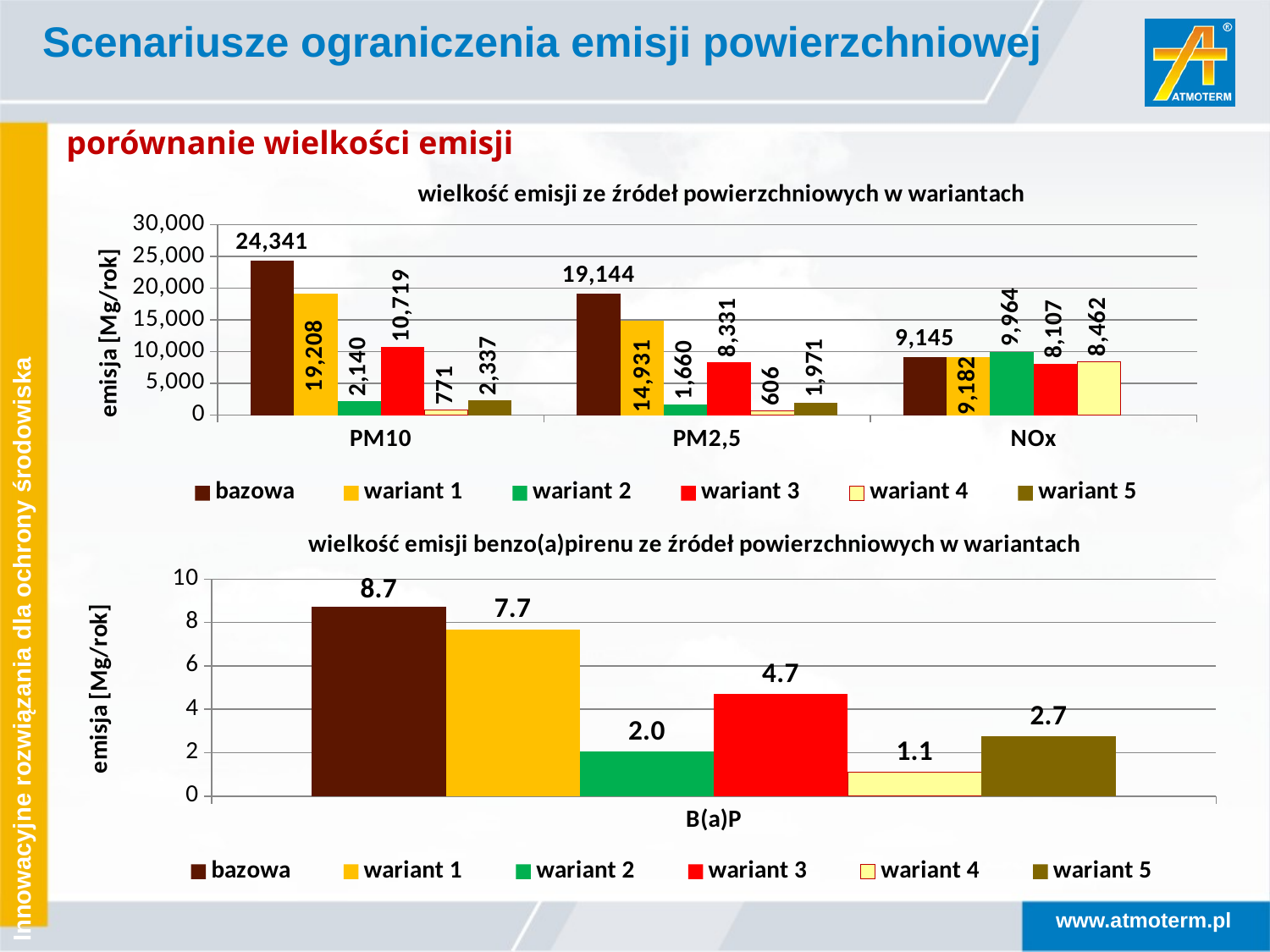
In the bottom chart, what is the wariant 3 value for B(a)P? 4.7 In the top chart, how many series does the legend list? 6 In the top chart, what is the difference between the bazowa and wariant 1 values for PM10? 5,133 In the bottom chart, what is the difference between the bazowa and wariant 4 values? 7.6 In the bottom chart, which series has the highest value for B(a)P? bazowa What kind of chart is the bottom chart? bar chart In the top chart, what is the wariant 2 value for NOx? 9,964 In the top chart, which series has the lowest value for PM10? wariant 4 In the top chart, which is larger for PM2,5: wariant 3 or wariant 5? wariant 3 In the top chart, what is the wariant 4 value for PM2,5? 606 In the top chart, what is the bazowa value for PM10? 24,341 In the top chart, how many categories are shown on the x axis? 3